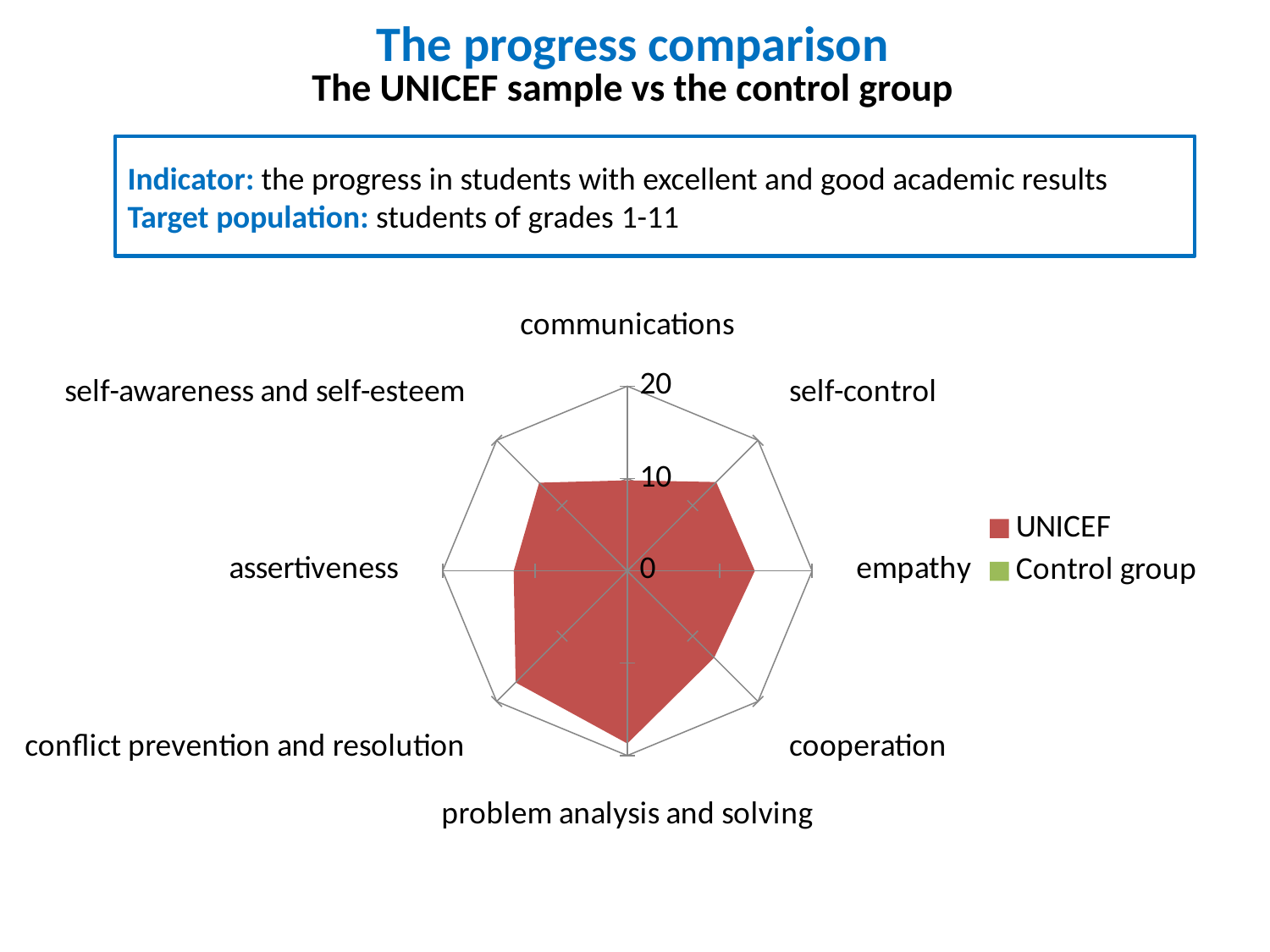
Which is larger for the UNICEF series: conflict prevention and resolution or self-control? conflict prevention and resolution What kind of chart is shown on the slide? radar chart How many series does the legend of the chart list? 2 Is the UNICEF value for cooperation greater or less than 20? less Which is larger for the UNICEF series: problem analysis and solving or communications? problem analysis and solving Which category has the highest value for the UNICEF series? problem analysis and solving How many categories (axes) does the radar chart have? 8 Is the UNICEF value for empathy greater or less than 20? less Is the UNICEF value for conflict prevention and resolution greater or less than 10? greater What are the two series named in the chart legend? UNICEF and Control group What colour represents the UNICEF series in the chart? red